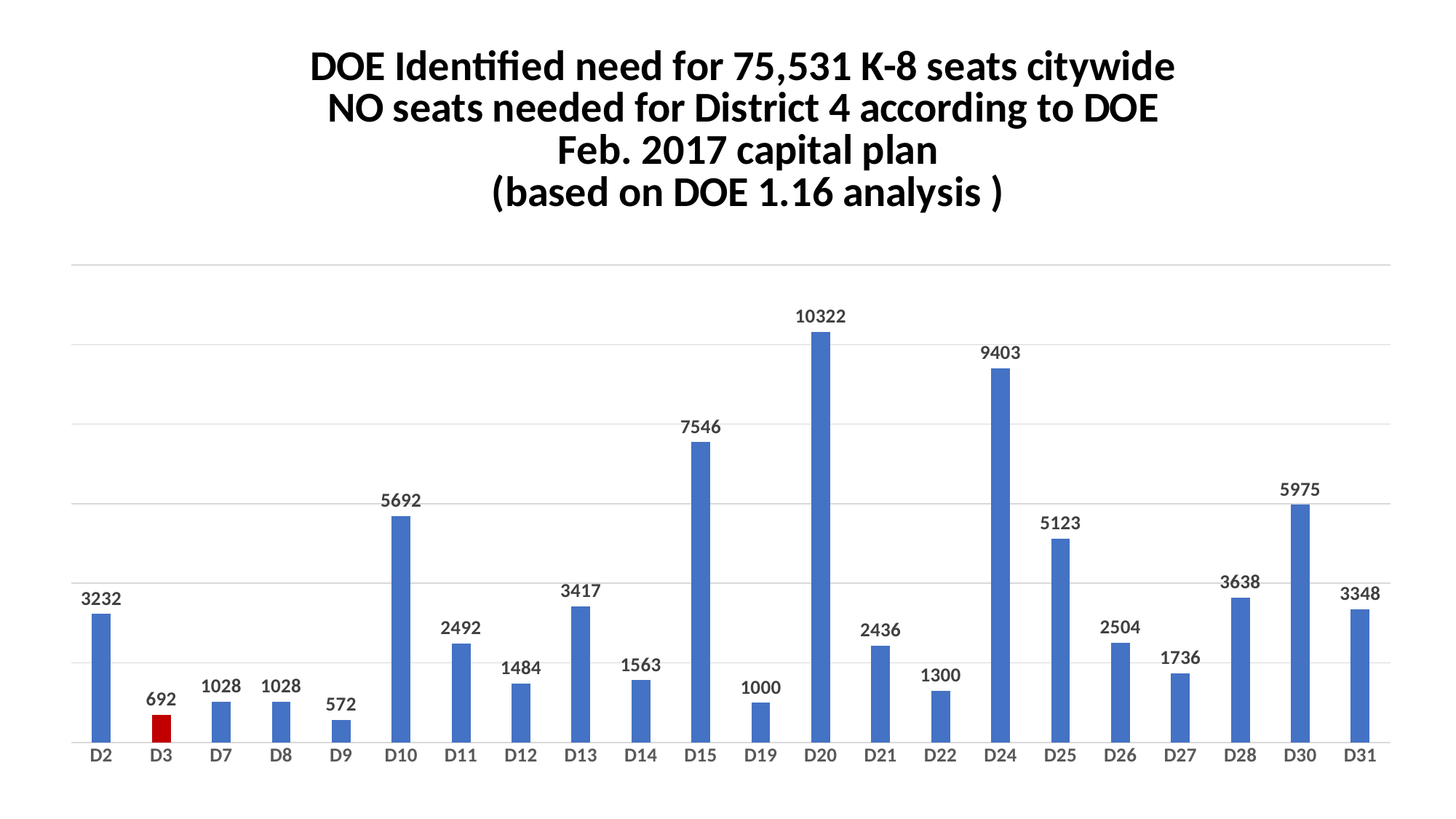
What is the difference between the values for D30 and D10? 283 What is the value for D3? 692 What is the value for D25? 5123 Which is larger, the value for D15 or the value for D24? D24 How many districts are shown on the x axis? 22 Which district has the highest value? D20 Which district's bar is coloured red instead of blue? D3 Which is larger, the value for D28 or the value for D31? D28 What is the value for D20? 10322 What is the difference between the values for D20 and D24? 919 Which district has the lowest value? D9 What kind of chart is shown on the slide? Bar chart